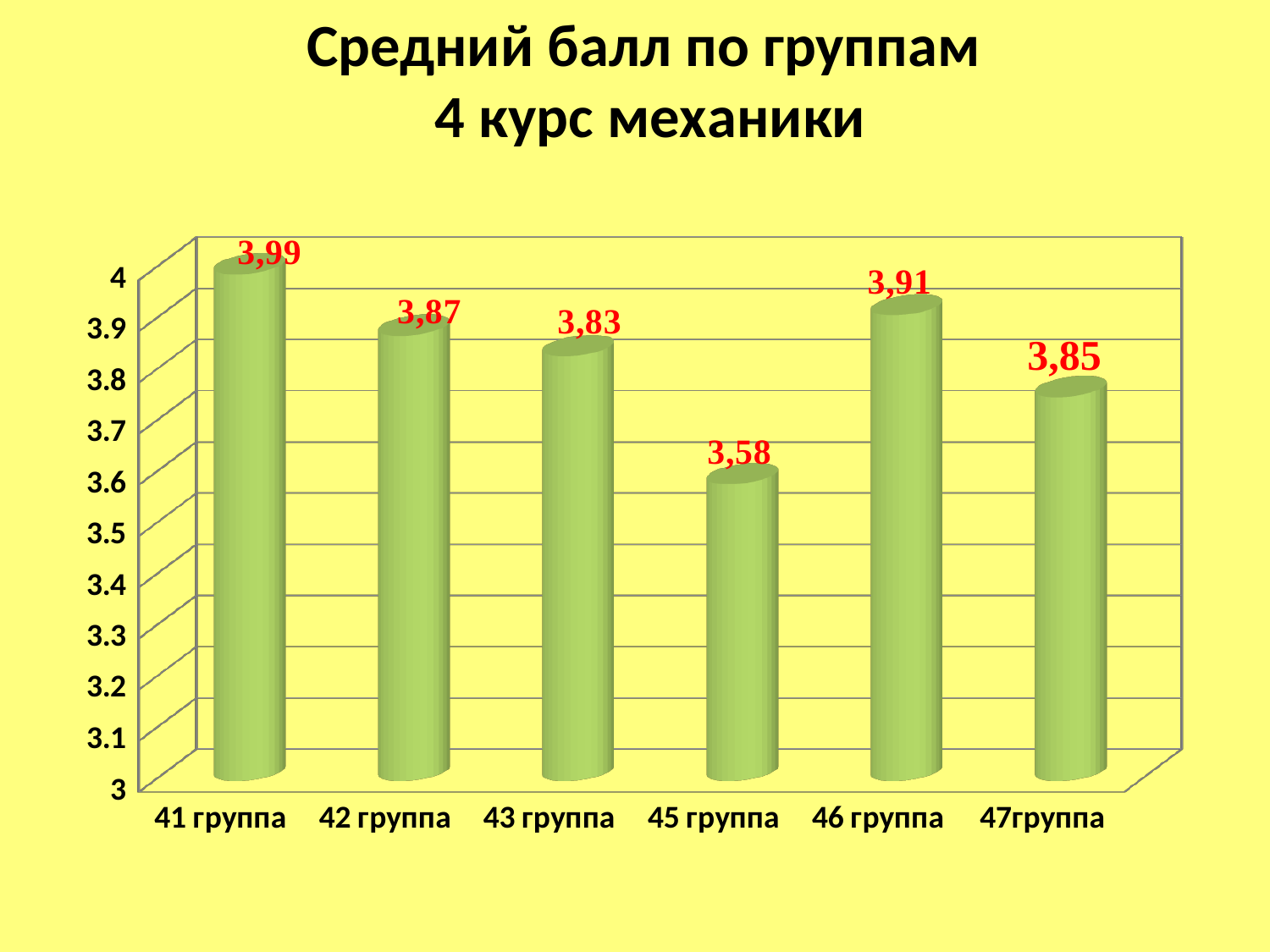
What is the average score for 46 группа? 3,91 Which has a higher average score, 46 группа or 47группа? 46 группа What is the average score for 45 группа? 3,58 What type of chart is shown on the slide? bar chart Which group has the lowest average score? 45 группа How many groups are shown in the chart? 6 What is the difference between the average scores of 41 группа and 45 группа? 0,41 What is the average score for 41 группа? 3,99 What is the average score for 47группа? 3,85 Is the value for 45 группа greater or less than 3.6? less Which group has the highest average score? 41 группа What is the difference between the average scores of 42 группа and 43 группа? 0,04